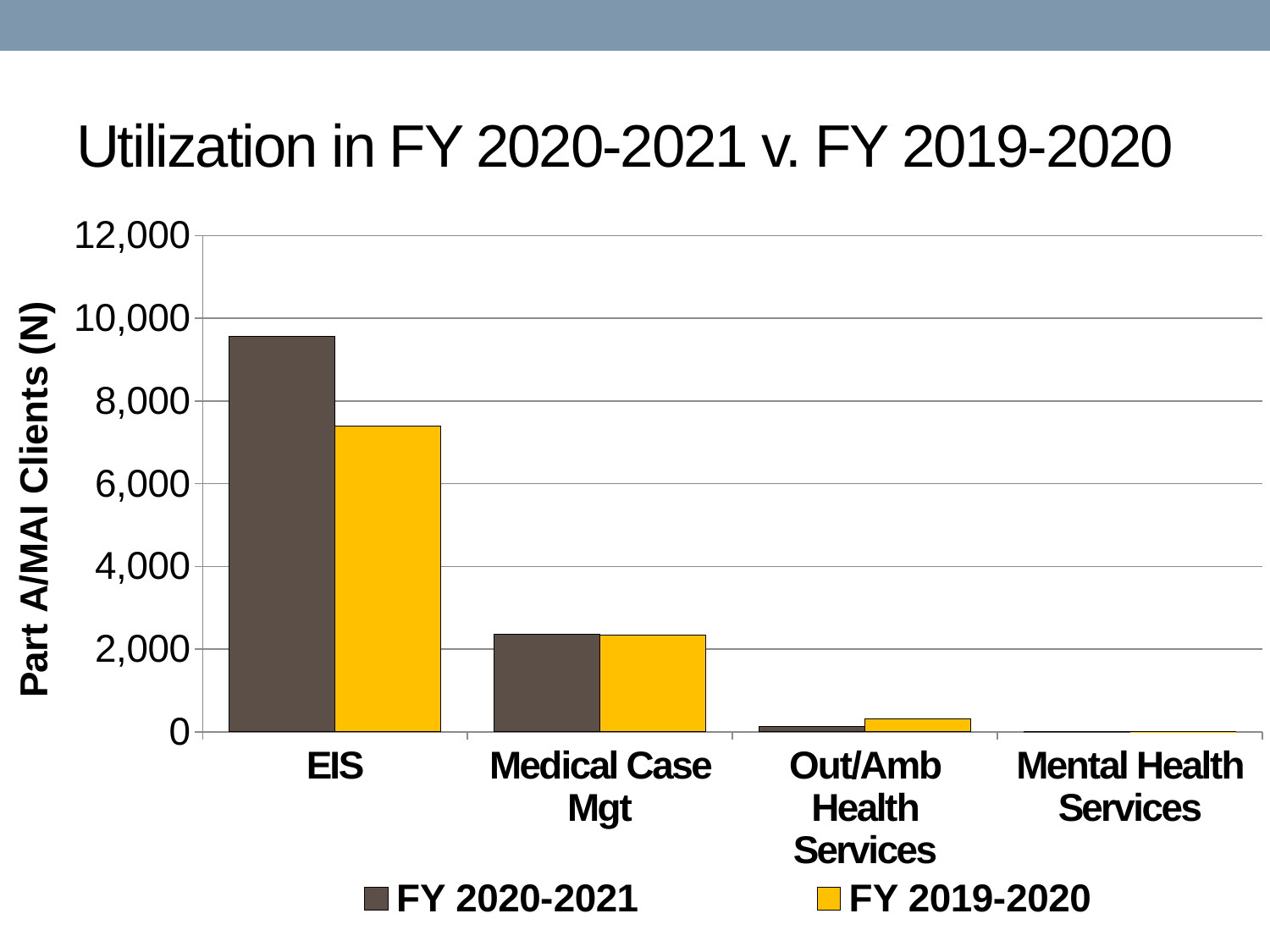
What is the label on the y axis of the chart? Part A/MAI Clients (N) Is the FY 2019-2020 value for EIS greater or less than 8,000? less For EIS, which fiscal year has the larger value, FY 2020-2021 or FY 2019-2020? FY 2020-2021 How many service categories are shown on the x axis? 4 What kind of chart is shown on the slide? bar chart Is the FY 2020-2021 value for EIS greater or less than 8,000? greater Which category has the lowest value for FY 2019-2020? Mental Health Services Is the FY 2020-2021 value for Medical Case Mgt greater or less than 2,000? greater How many series does the legend list? 2 Which category has the highest value for FY 2020-2021? EIS For Out/Amb Health Services, which fiscal year has the larger value, FY 2020-2021 or FY 2019-2020? FY 2019-2020 Do the FY 2020-2021 values rise or fall moving from EIS to Mental Health Services along the x axis? fall